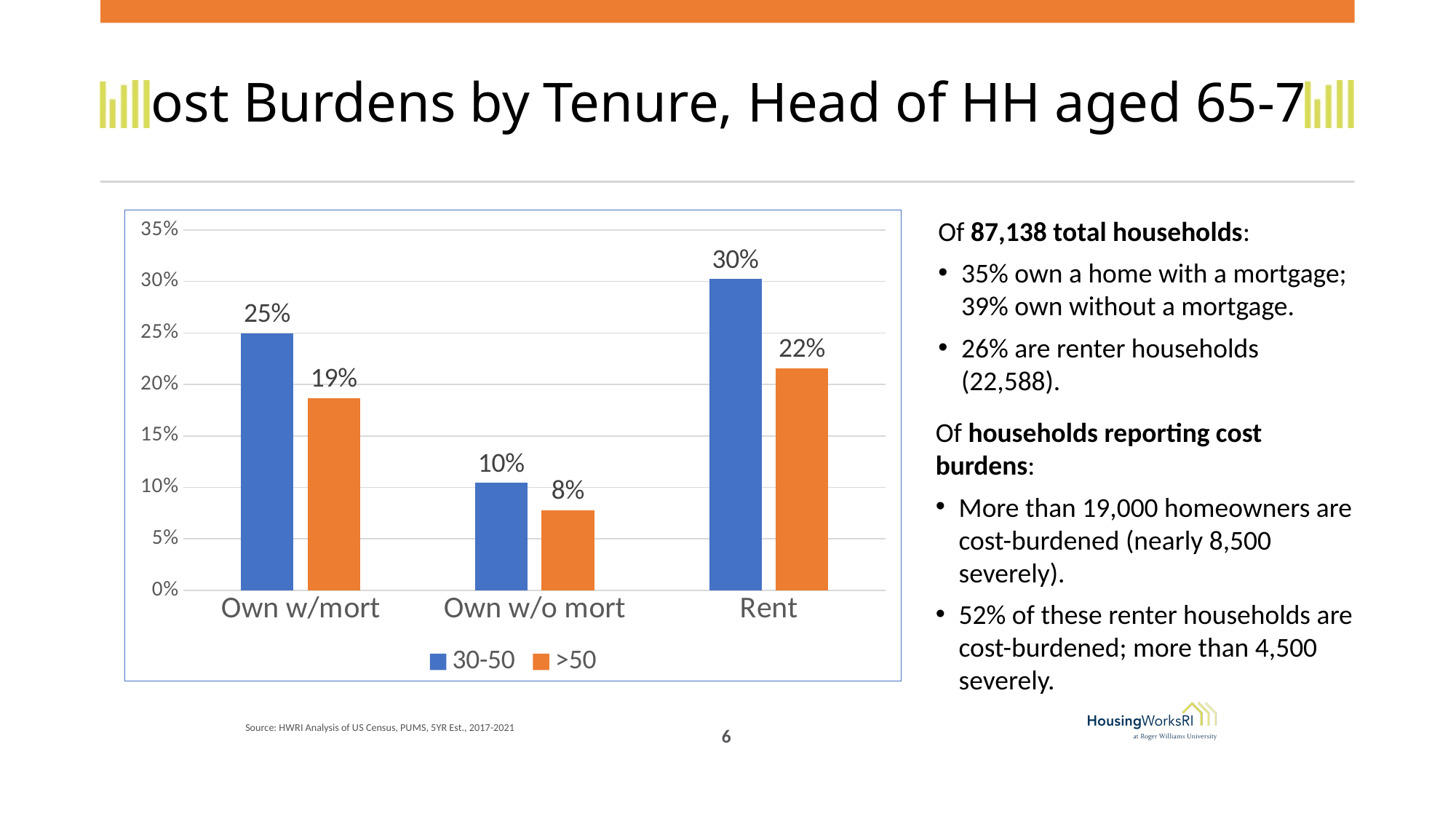
Which is larger: the 30-50 value for Own w/mort or the >50 value for Rent? 30-50 value for Own w/mort Which category has the lowest value for the >50 series? Own w/o mort How many series does the legend list? 2 Which category has the highest value for the 30-50 series? Rent What colour represents the >50 series in the chart? Orange What is the value for the >50 series in the Own w/o mort category? 8% How many categories are shown on the x axis? 3 What kind of chart is shown on the slide? Bar chart What is the value for the >50 series in the Rent category? 22% What is the difference between the 30-50 and >50 values in the Own w/mort category? 6% Is the 30-50 value for Rent greater or less than 25%? greater What is the value for the 30-50 series in the Own w/mort category? 25%